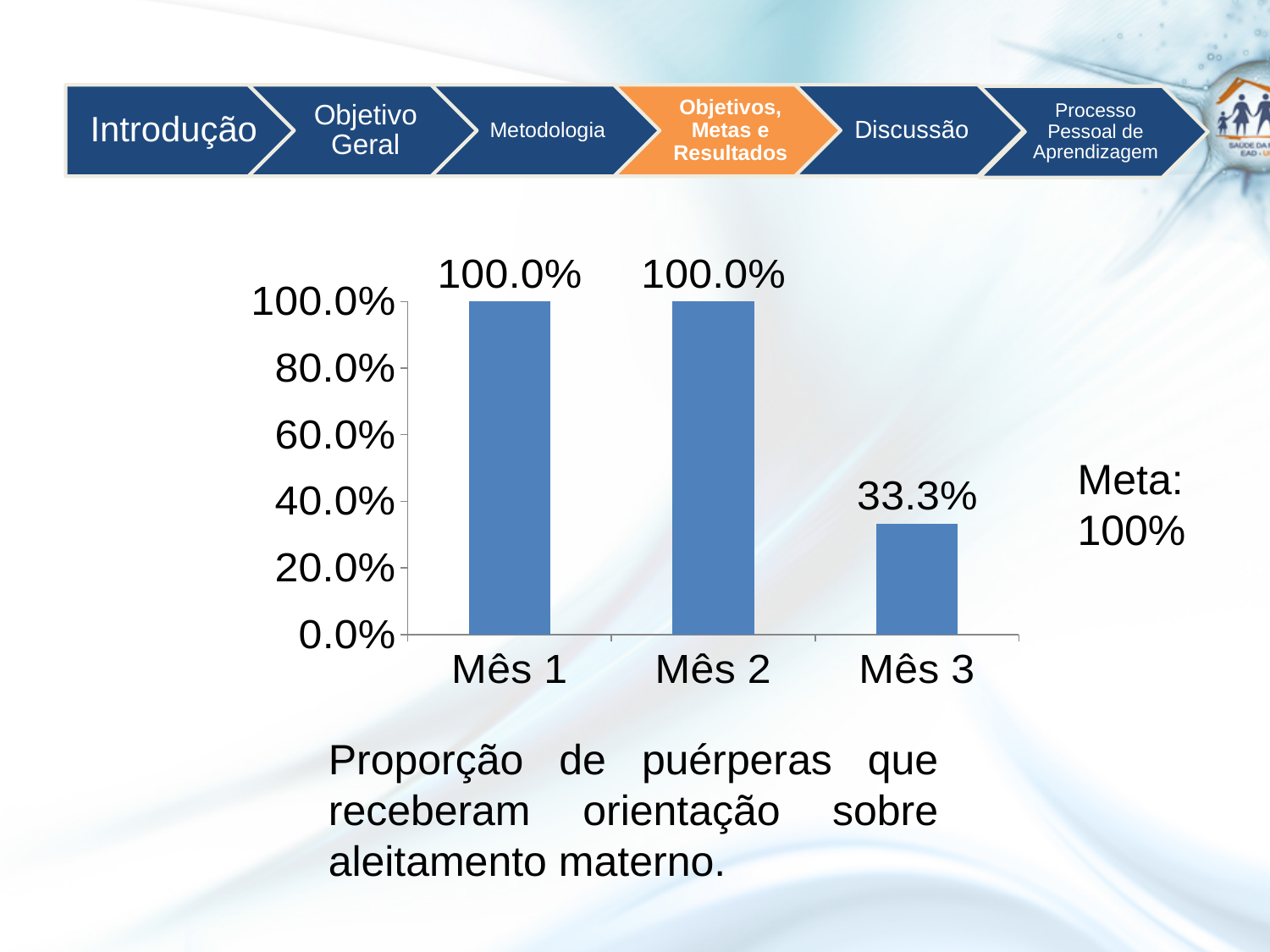
Is the value for Mês 3 greater or less than 40.0%? less What is the difference between the values for Mês 1 and Mês 3? 66.7% What kind of chart is shown on the slide? bar chart What is the value for Mês 1? 100.0% What is the highest value shown on the y axis? 100.0% What is the value for Mês 3? 33.3% What is the target (Meta) stated next to the chart? 100% Do the values rise or fall from Mês 2 to Mês 3? fall Which month has the lowest value? Mês 3 Which is larger, the value for Mês 2 or the value for Mês 3? Mês 2 What is the value for Mês 2? 100.0% How many categories are shown on the x axis? 3